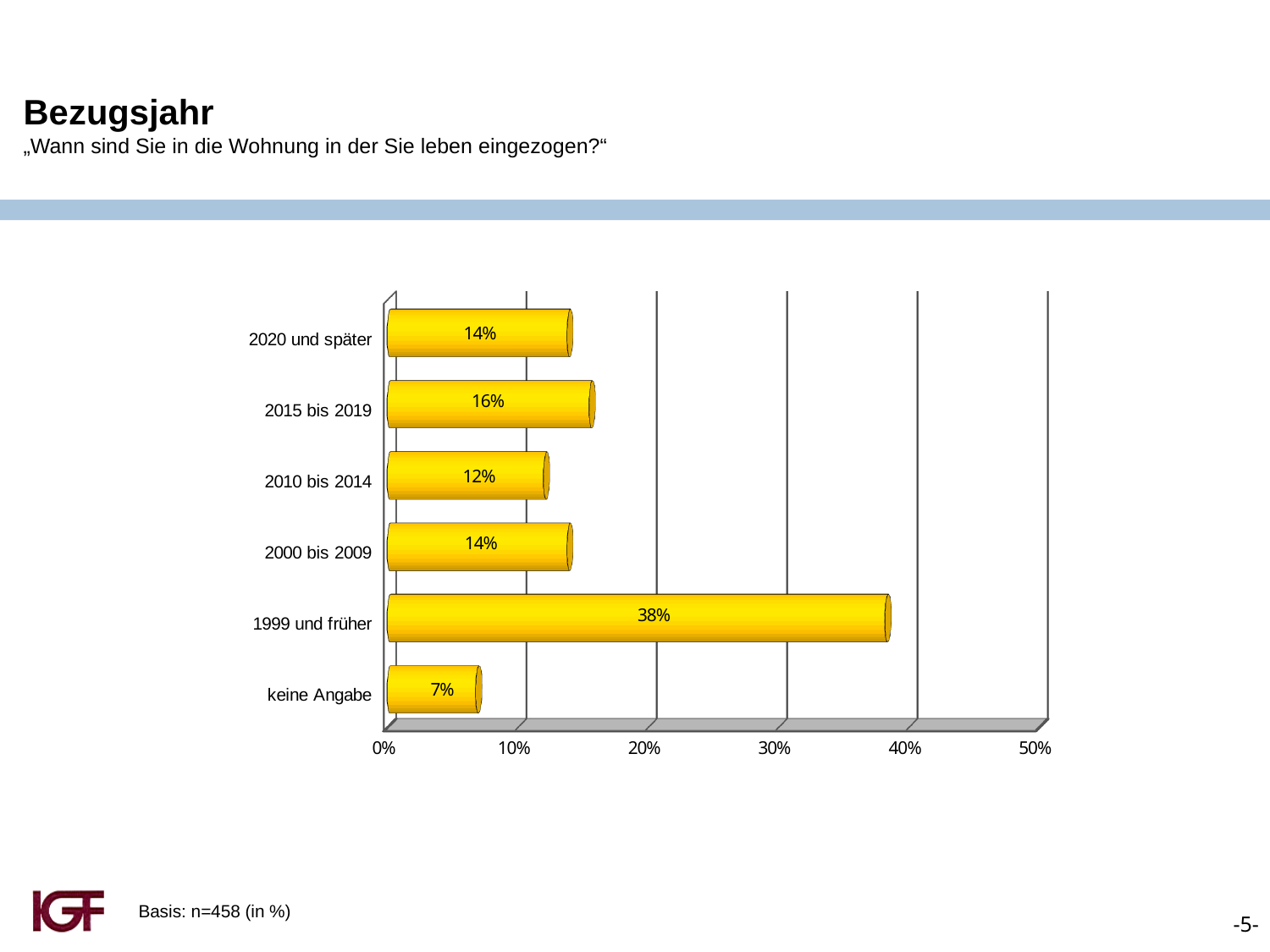
What is the value for "2015 bis 2019"? 16% What is the value for "2010 bis 2014"? 12% What is the title of the chart on the slide? Bezugsjahr Which category has the lowest value? keine Angabe How many categories are shown in the chart? 6 Which is larger, the value for "2015 bis 2019" or the value for "2010 bis 2014"? 2015 bis 2019 What is the value for "keine Angabe"? 7% What kind of chart is shown on the slide? bar chart Which category has the highest value? 1999 und früher Is the value for "1999 und früher" greater or less than 30%? greater What is the value for "1999 und früher"? 38% What is the difference between the values for "1999 und früher" and "2015 bis 2019"? 22%